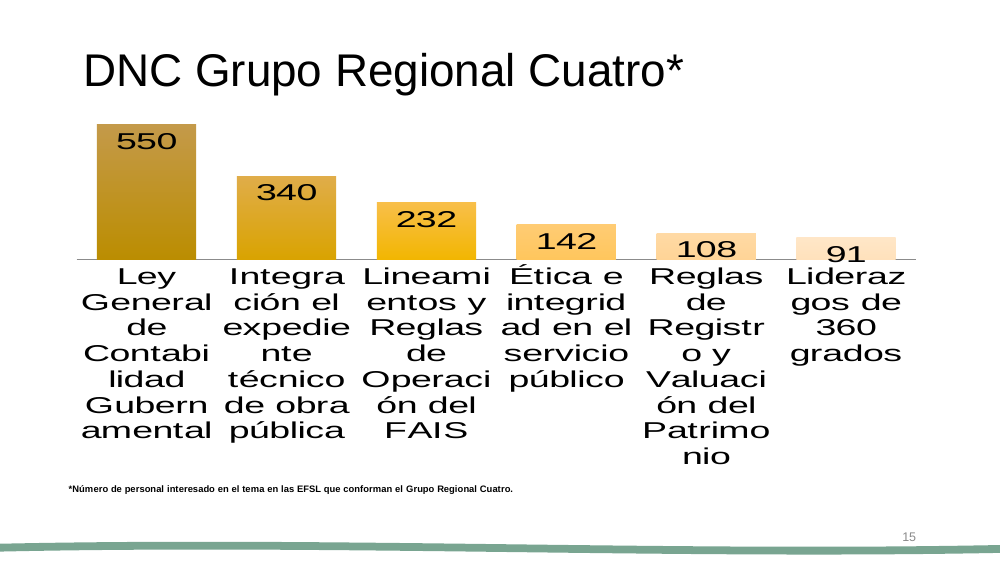
What is the value for Ley General de Contabilidad Gubernamental? 550 How many categories are shown in the chart? 6 What is the title of the chart? DNC Grupo Regional Cuatro* Which category has the lowest value? Liderazgos de 360 grados Which is larger, the value for Reglas de Registro y Valuación del Patrimonio or the value for Ética e integridad en el servicio público? Ética e integridad en el servicio público What kind of chart is shown on the slide? Bar chart Do the values rise or fall from left to right along the x axis? Fall What is the difference between the highest and lowest values in the chart? 459 Which category has the highest value? Ley General de Contabilidad Gubernamental What is the difference between the values for Integración el expediente técnico de obra pública and Lineamientos y Reglas de Operación del FAIS? 108 What is the value for Ética e integridad en el servicio público? 142 What is the value for Liderazgos de 360 grados? 91